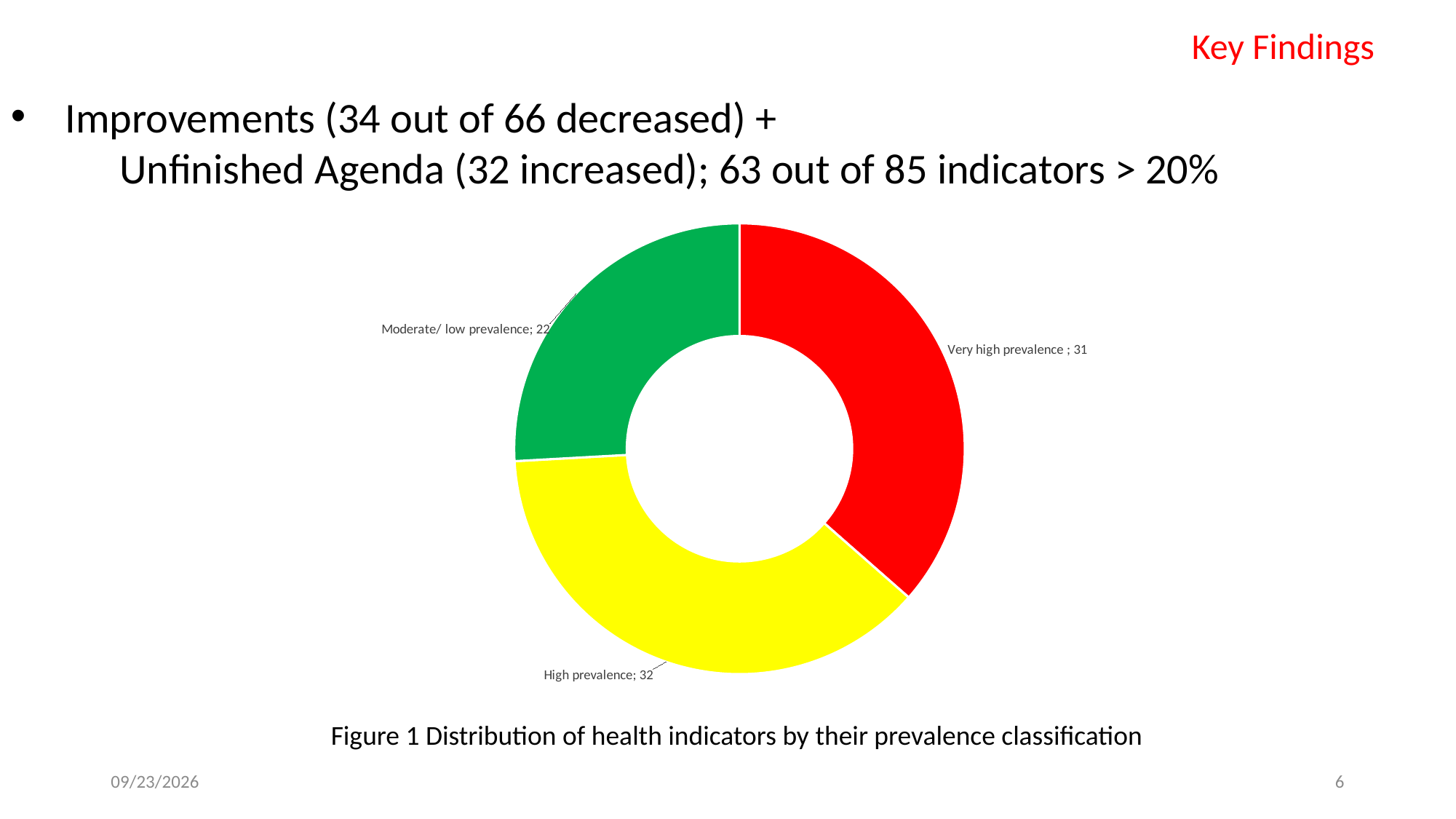
Which has more indicators: Very high prevalence or Moderate/ low prevalence? Very high prevalence How many indicators are classified as Moderate/ low prevalence? 22 How many indicators are classified as High prevalence? 32 How many indicators are classified as Very high prevalence? 31 What is the difference between the number of High prevalence indicators and Moderate/ low prevalence indicators? 10 What colour is the Very high prevalence slice? Red What is the total number of indicators across all three categories in the chart? 85 What is the difference between the number of Very high prevalence indicators and Moderate/ low prevalence indicators? 9 How many categories does the chart show? 3 What kind of chart is shown on the slide? Doughnut chart Which prevalence category has the fewest indicators? Moderate/ low prevalence